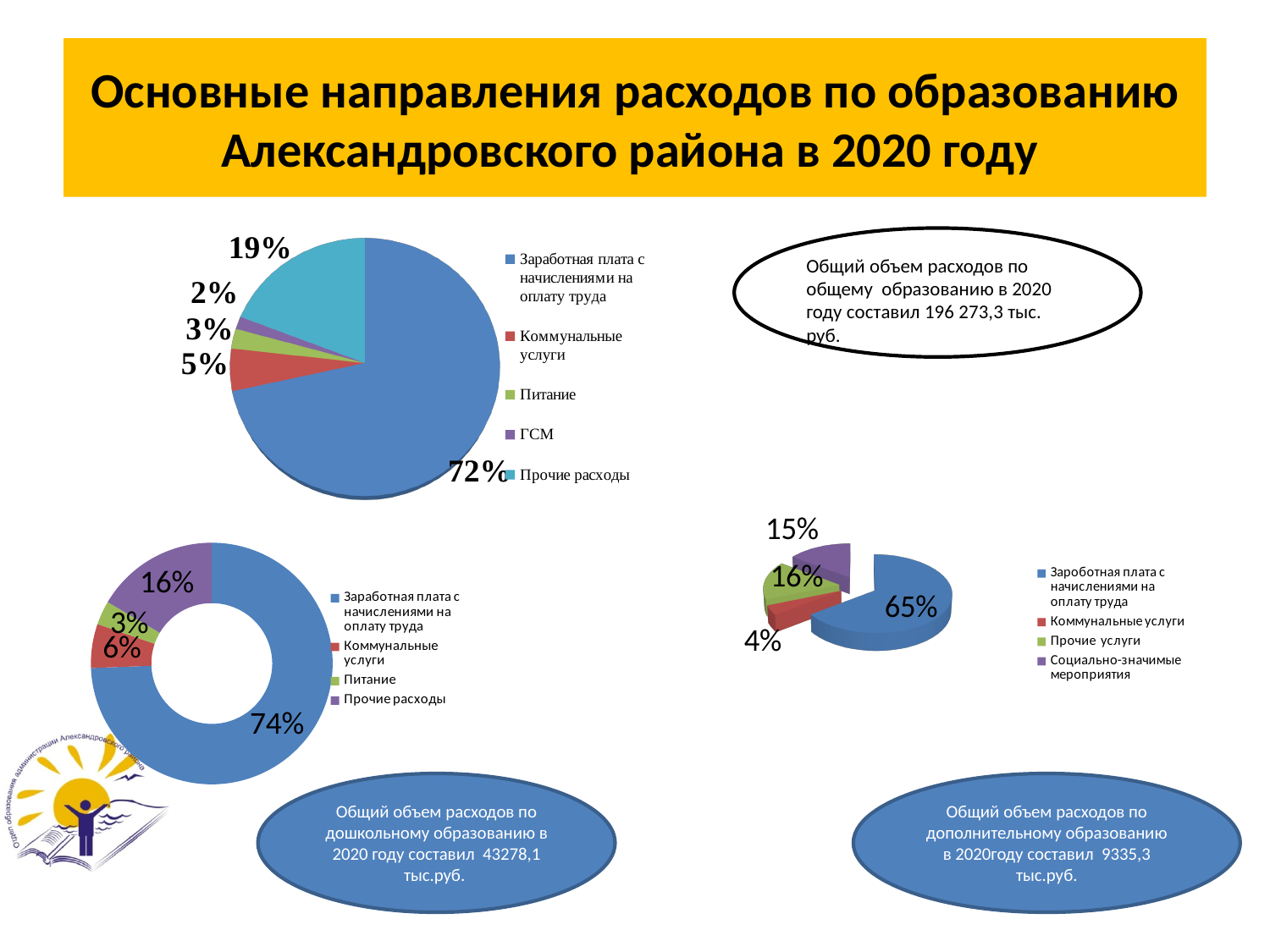
In the top-left pie chart, which category has the smallest share? ГСМ In the bottom-right pie chart, what share is labelled for Социально-значимые мероприятия? 15% In the top-left pie chart, what share is labelled for Прочие расходы? 19% How many categories does the legend of the bottom-left donut chart list? 4 In the bottom-right pie chart, which category has the smallest share? Коммунальные услуги How many categories does the legend of the top-left pie chart list? 5 In the bottom-right pie chart, what share is labelled for Заработная плата с начислениями на оплату труда? 65% In the bottom-left donut chart, what share is labelled for Прочие расходы? 16% In the bottom-left donut chart, what share is labelled for Заработная плата с начислениями на оплату труда? 74% In the bottom-left donut chart, which is larger: Коммунальные услуги or Питание? Коммунальные услуги In the top-left pie chart, what is the difference between the shares for Коммунальные услуги and Питание? 2% In the top-left pie chart, what share is labelled for Заработная плата с начислениями на оплату труда? 72%